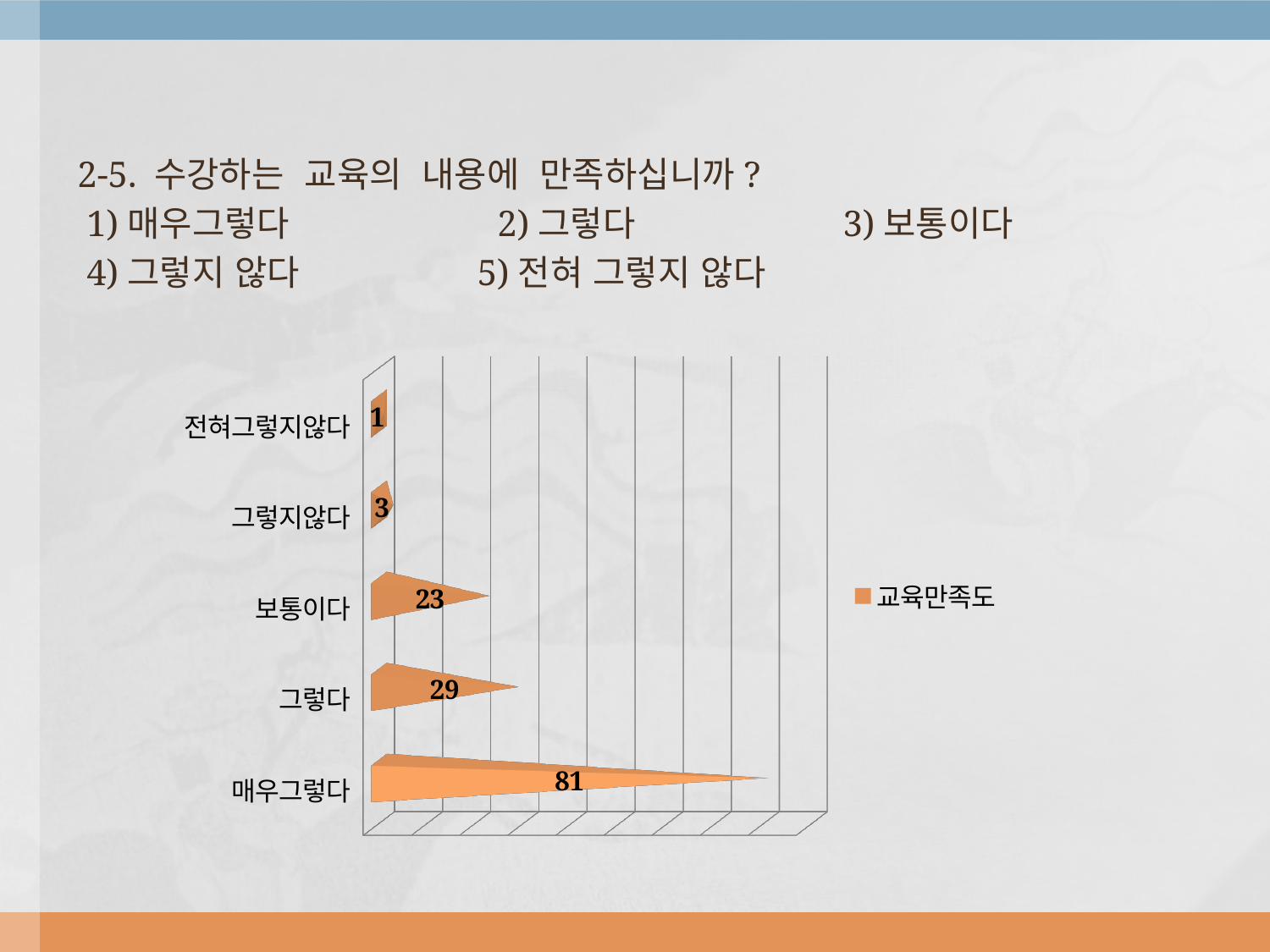
What is the value for 전혀그렇지않다? 1 Which category has the highest value? 매우그렇다 What is the value for 보통이다? 23 Which is larger, the value for 보통이다 or the value for 그렇지않다? 보통이다 What is the difference between the values for 그렇다 and 보통이다? 6 What is the name of the series listed in the legend? 교육만족도 What is the value for 그렇지않다? 3 What is the difference between the values for 매우그렇다 and 그렇다? 52 What is the value for 매우그렇다? 81 How many categories are shown in the chart? 5 What is the value for 그렇다? 29 Which category has the lowest value? 전혀그렇지않다